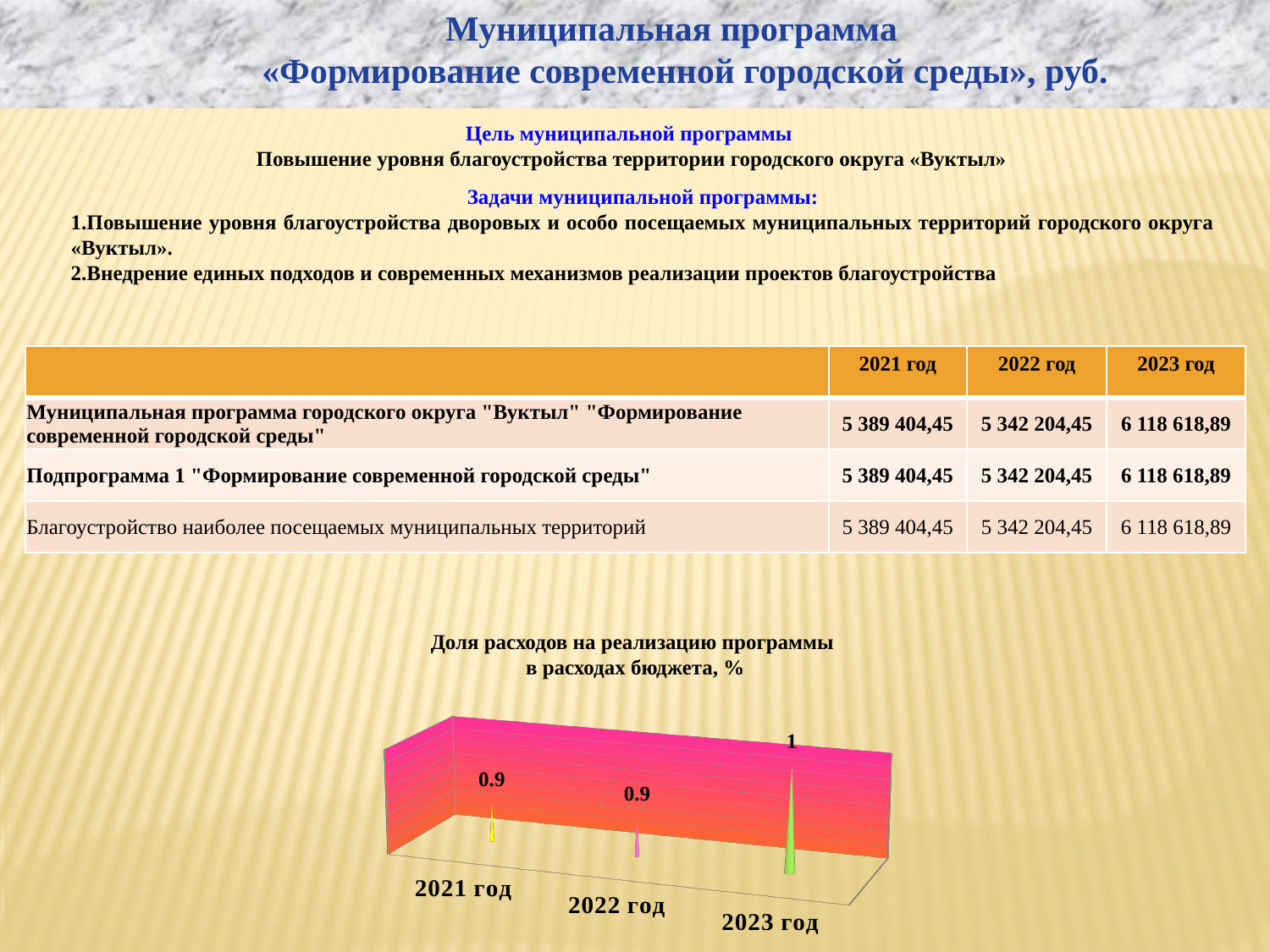
How many years are shown in the chart? 3 Do the values rise or fall from 2021 год to 2023 год? rise What is the title of the chart? Доля расходов на реализацию программы в расходах бюджета, % What is the value for 2023 год in the chart? 1 Which year has the highest value in the chart? 2023 год What is the value for 2021 год in the chart? 0.9 What kind of chart is shown on the slide? bar chart Which is larger, the value for 2022 год or the value for 2023 год? 2023 год What is the value for 2022 год in the chart? 0.9 What is the difference between the values for 2023 год and 2021 год? 0.1